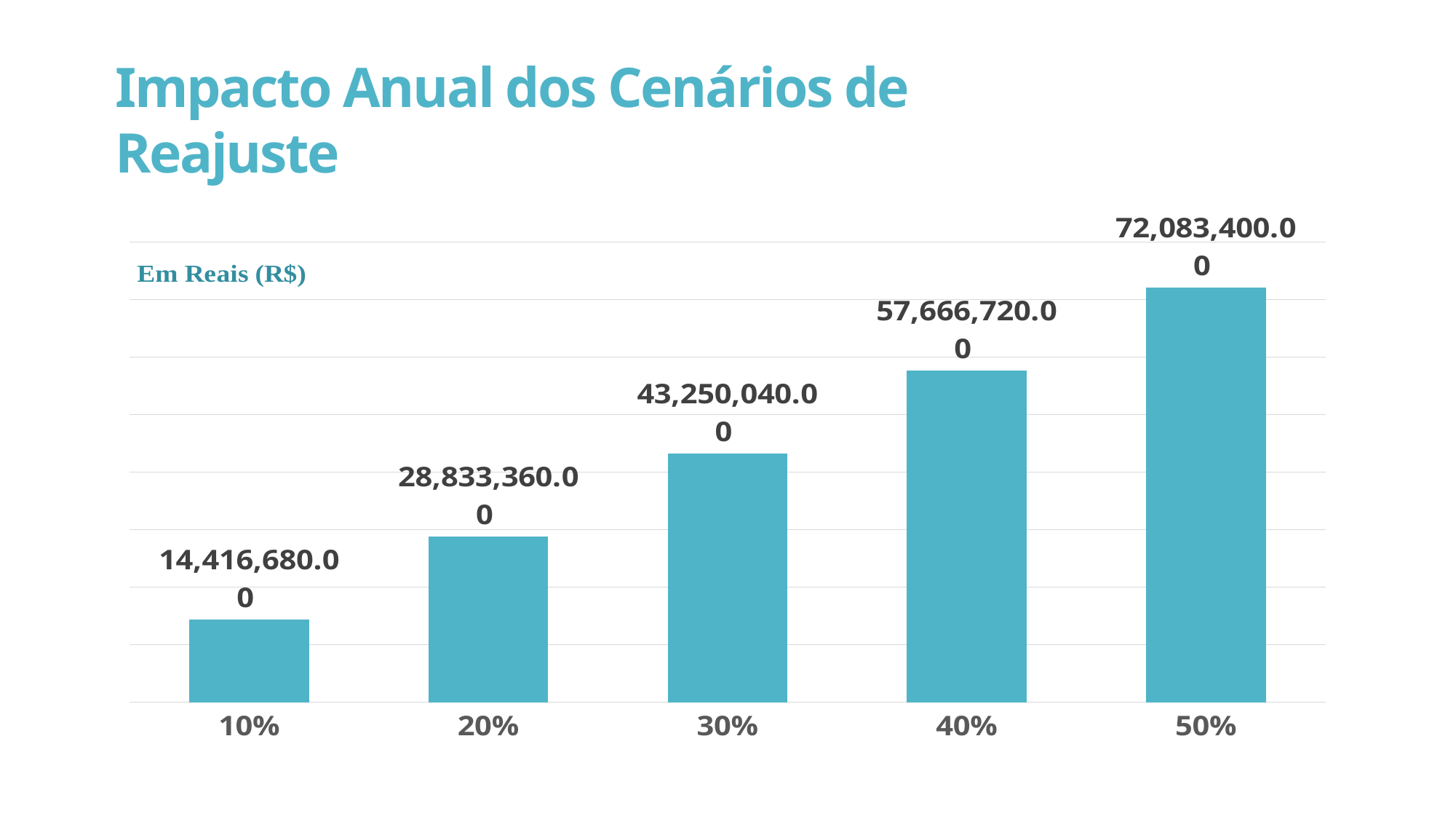
What kind of chart is shown on the slide? Bar chart Which scenario has the highest annual impact? 50% What is the value for the 10% scenario? 14,416,680.00 Which is larger, the value for 40% or the value for 30%? 40% How many scenarios are shown on the x axis? 5 What is the difference between the values for the 50% and 40% scenarios? 14,416,680.00 Which scenario has the lowest annual impact? 10% What is the difference between the values for the 20% and 10% scenarios? 14,416,680.00 Do the values rise or fall as the reajuste percentage increases along the x axis? Rise What is the value for the 50% scenario? 72,083,400.00 What is the value for the 30% scenario? 43,250,040.00 What unit label is shown at the top left of the chart? Em Reais (R$)